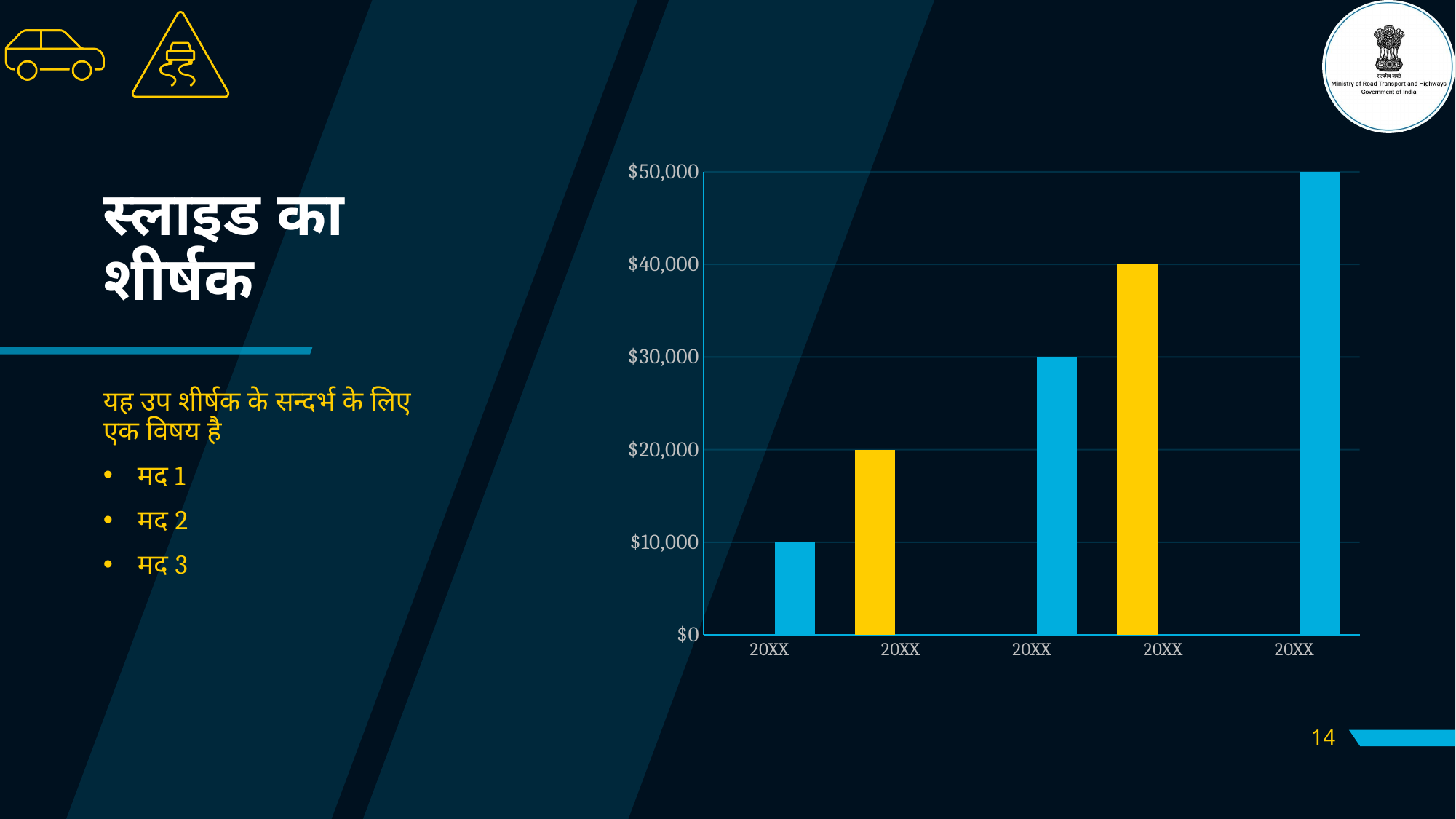
How many bars are plotted in the chart? 5 What is the difference between the rightmost bar and the leftmost bar in the chart? $40,000 What is the value of the fourth bar from the left in the chart? $40,000 What is the value of the second bar from the left in the chart? $20,000 What label is shown under each bar on the x axis of the chart? 20XX Which bar has the lowest value in the chart? the leftmost (first) bar What is the value of the third bar from the left in the chart? $30,000 What is the value of the first (leftmost) bar in the chart? $10,000 Do the bar values rise or fall from left to right along the x axis? rise What kind of chart is shown on the slide? bar chart What is the value of the last (rightmost) bar in the chart? $50,000 Which bar has the highest value in the chart? the rightmost (fifth) bar